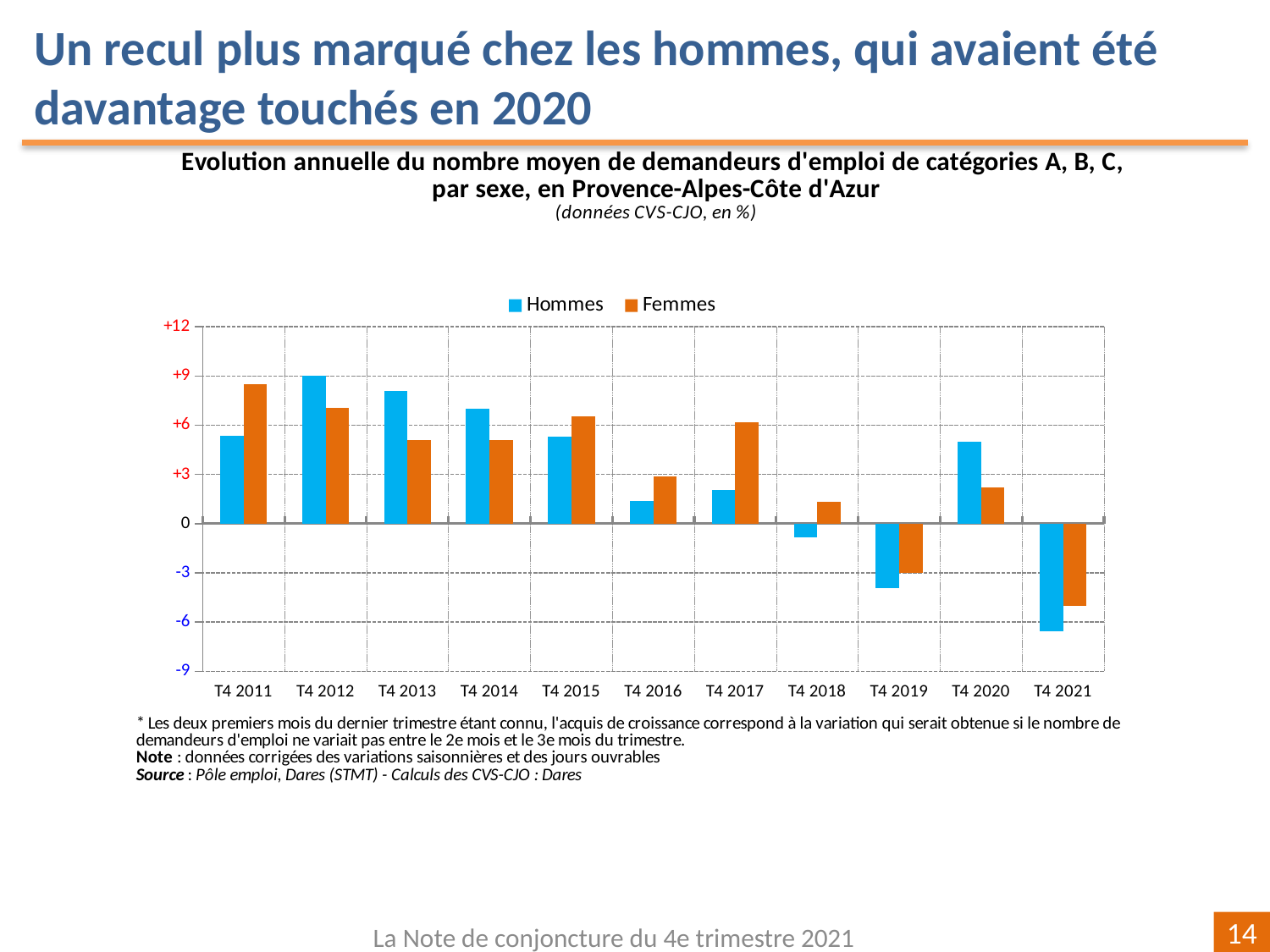
Is the Hommes value for T4 2021 greater or less than -6? less In which quarter is the Femmes value the highest? T4 2011 How many series does the legend list? 2 In which quarter is the Hommes value the highest? T4 2012 In which quarter is the Femmes value the lowest? T4 2021 What kind of chart is shown on the slide? Bar chart In T4 2017, which series has the larger value, Hommes or Femmes? Femmes In which quarter is the Hommes value the lowest? T4 2021 Which colour represents the Hommes series in the legend? Blue Is the Femmes value for T4 2011 greater or less than +6? greater How many quarters (categories) are shown on the x axis? 11 Is the Hommes value for T4 2020 greater or less than +3? greater